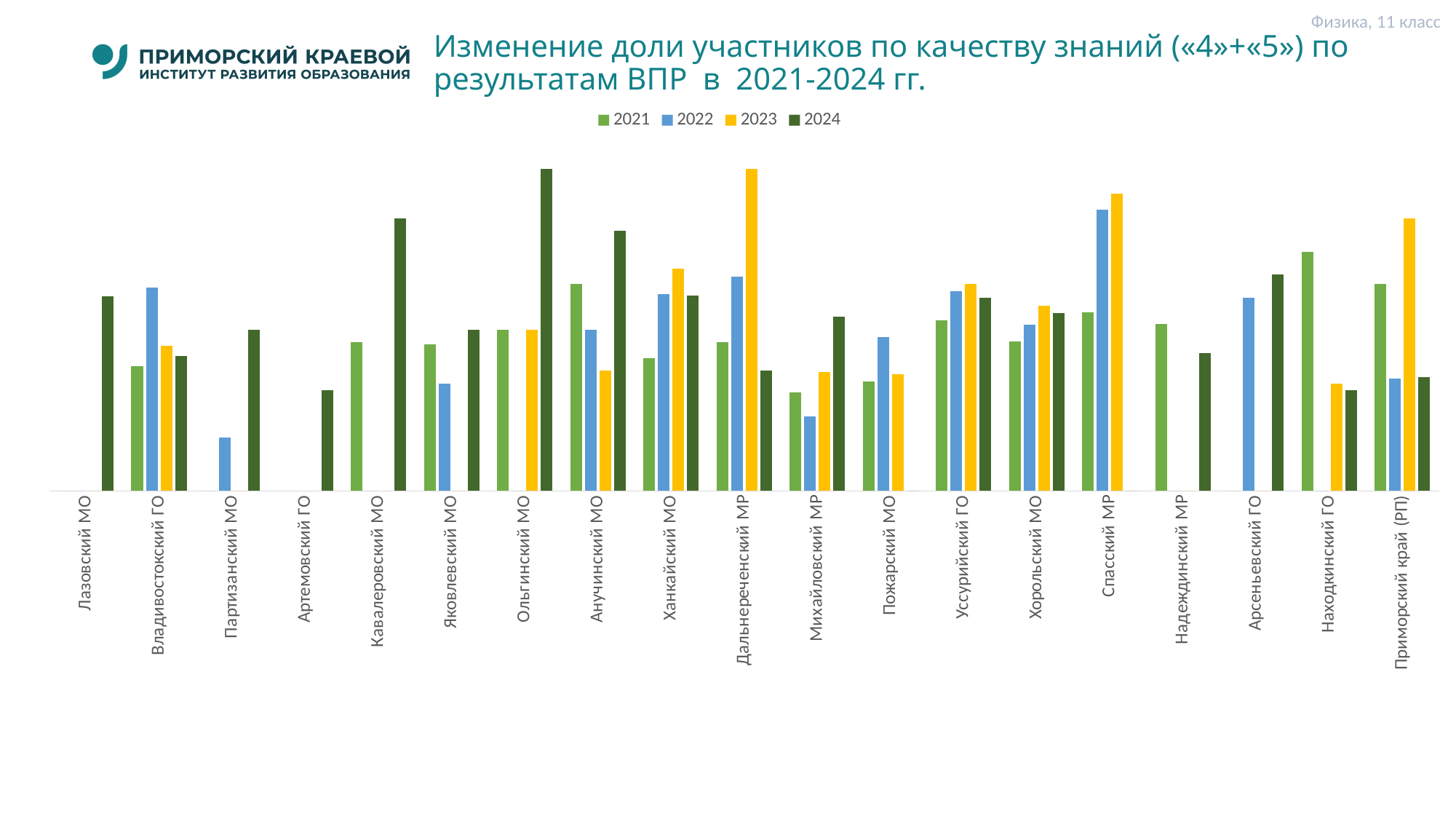
Which colour represents the 2023 series in the legend? Yellow Which category has the tallest 2022 bar? Спасский МР Which category has the tallest 2021 bar? Находкинский ГО Which years are listed in the legend? 2021, 2022, 2023, 2024 Which category has the shortest 2022 bar? Партизанский МО How many categories (municipalities) are shown along the x axis? 19 Which category has the tallest 2024 bar? Ольгинский МО What kind of chart is shown on the slide? Bar chart How many bars are shown for Артемовский ГО? 1 For Кавалеровский МО, which is larger: the 2021 value or the 2024 value? 2024 For Приморский край (РП), is the 2024 value higher or lower than the 2023 value? Lower How many series does the legend list? 4